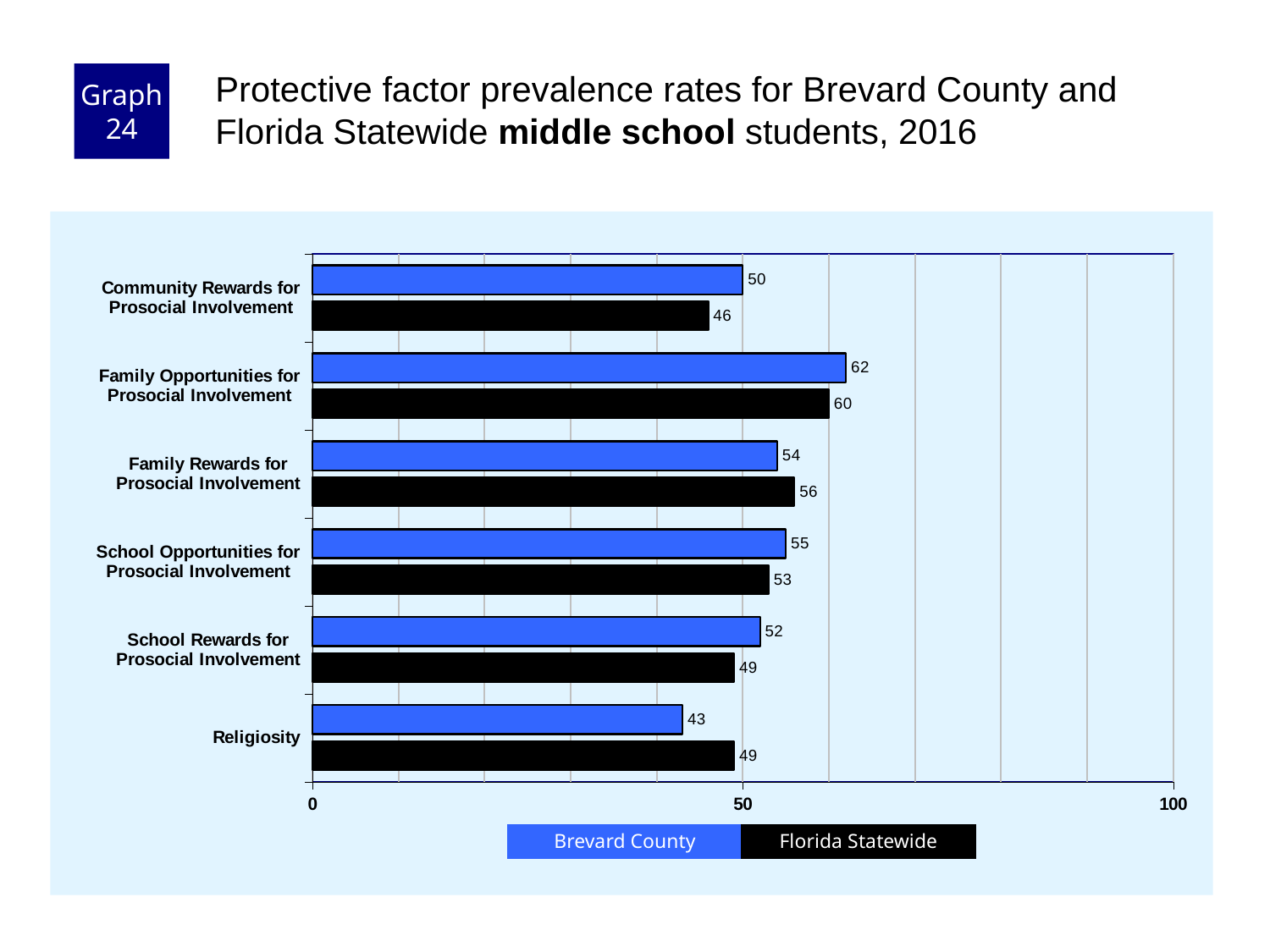
Which is larger for Family Rewards for Prosocial Involvement, the Brevard County value or the Florida Statewide value? Florida Statewide What is the Florida Statewide value for Community Rewards for Prosocial Involvement? 46 Is the Brevard County value for Religiosity greater or less than 50? less Which category has the highest Brevard County value? Family Opportunities for Prosocial Involvement Which colour represents Florida Statewide in the chart? black How many series does the legend list? 2 What kind of chart is shown on the slide? bar chart What is the Florida Statewide value for Religiosity? 49 What is the difference between the Brevard County and Florida Statewide values for Community Rewards for Prosocial Involvement? 4 How many categories are shown on the chart? 6 Which category has the lowest Brevard County value? Religiosity What is the Brevard County value for Family Opportunities for Prosocial Involvement? 62